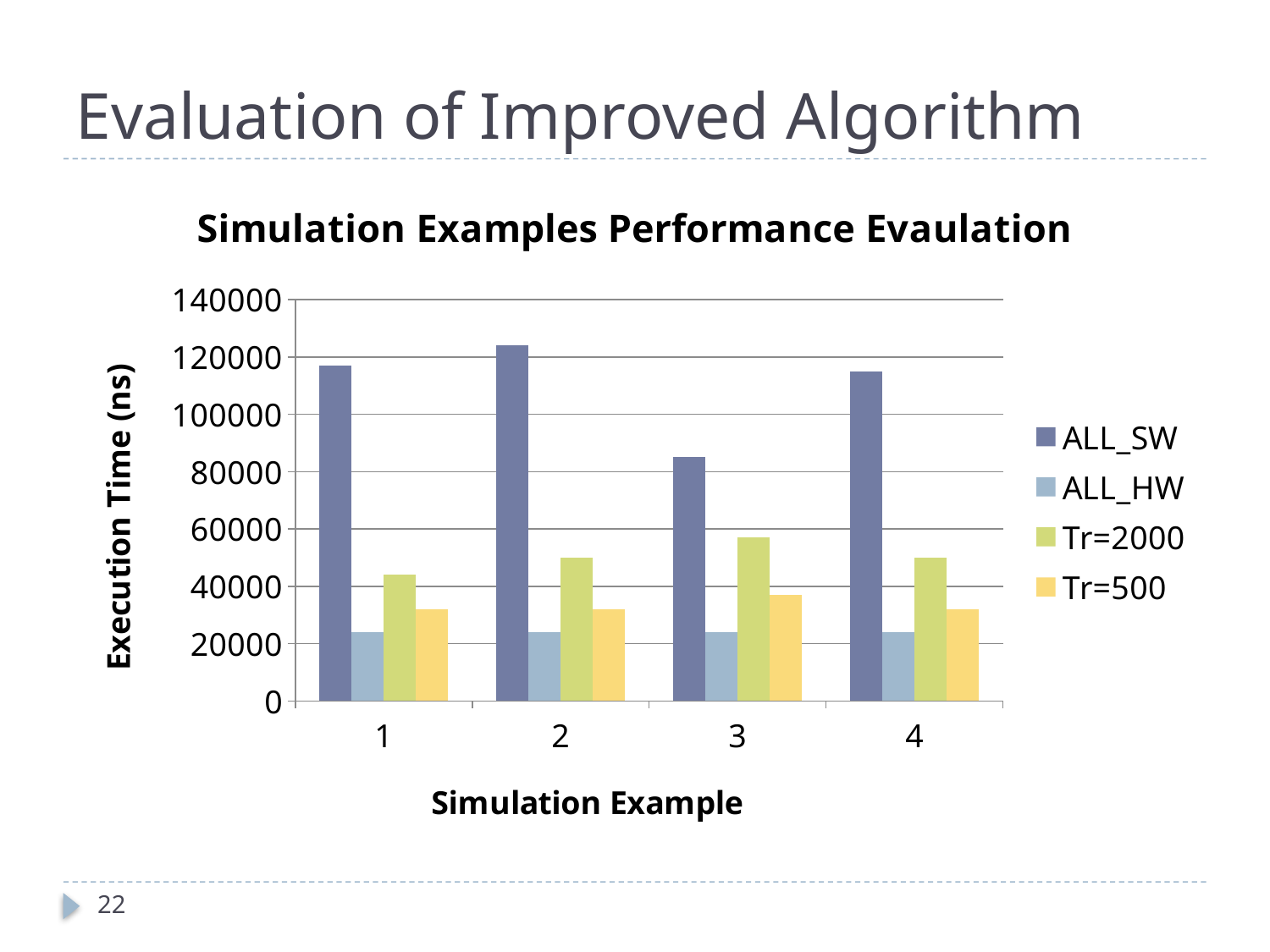
For which simulation example is the ALL_SW execution time highest? 2 For which simulation example is the ALL_SW execution time lowest? 3 For which simulation example is the Tr=2000 execution time highest? 3 In simulation example 3, which series has the larger execution time, Tr=2000 or Tr=500? Tr=2000 How many simulation examples are shown on the x axis? 4 Is the Tr=2000 value for simulation example 3 greater or less than 60000? less What type of chart is shown on the slide? bar chart Is the ALL_SW value for simulation example 3 greater or less than 80000? greater Is the ALL_HW value for simulation example 1 greater or less than 40000? less What is the label of the y axis? Execution Time (ns) How many series does the legend list? 4 What is the title of the chart? Simulation Examples Performance Evaulation